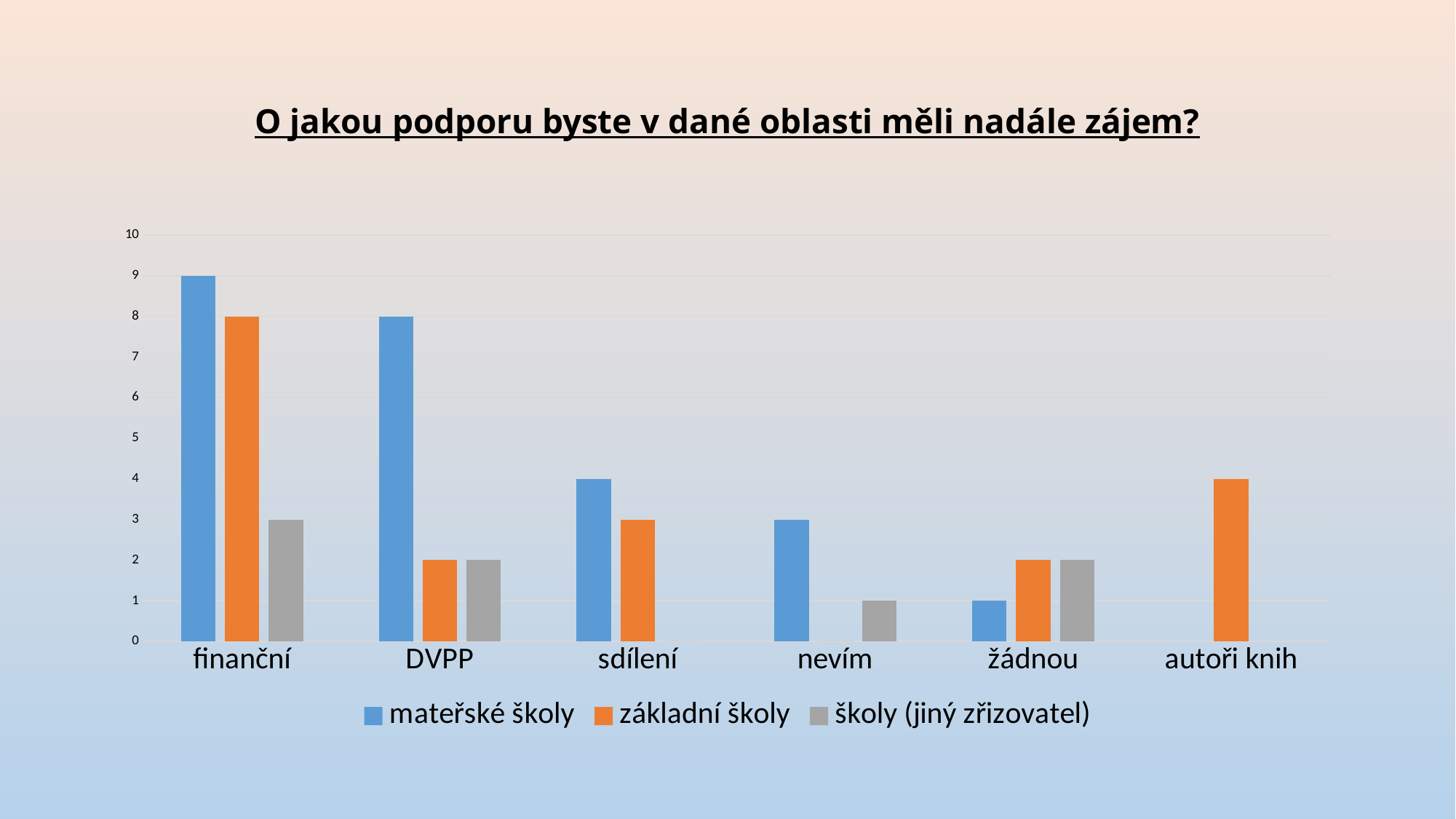
Is the value for mateřské školy in the sdílení category greater or less than 5? less What is the value for základní školy in the autoři knih category? 4 What is the title of the chart? O jakou podporu byste v dané oblasti měli nadále zájem? What is the difference between the mateřské školy and základní školy values in the DVPP category? 6 Which category has the highest value for mateřské školy? finanční How many categories are shown on the x axis? 6 In the žádnou category, which is larger: the value for mateřské školy or for základní školy? základní školy How many series does the legend list? 3 Which category has the lowest value for základní školy? nevím What type of chart is shown on the slide? bar chart What is the value for školy (jiný zřizovatel) in the finanční category? 3 What is the value for mateřské školy in the finanční category? 9